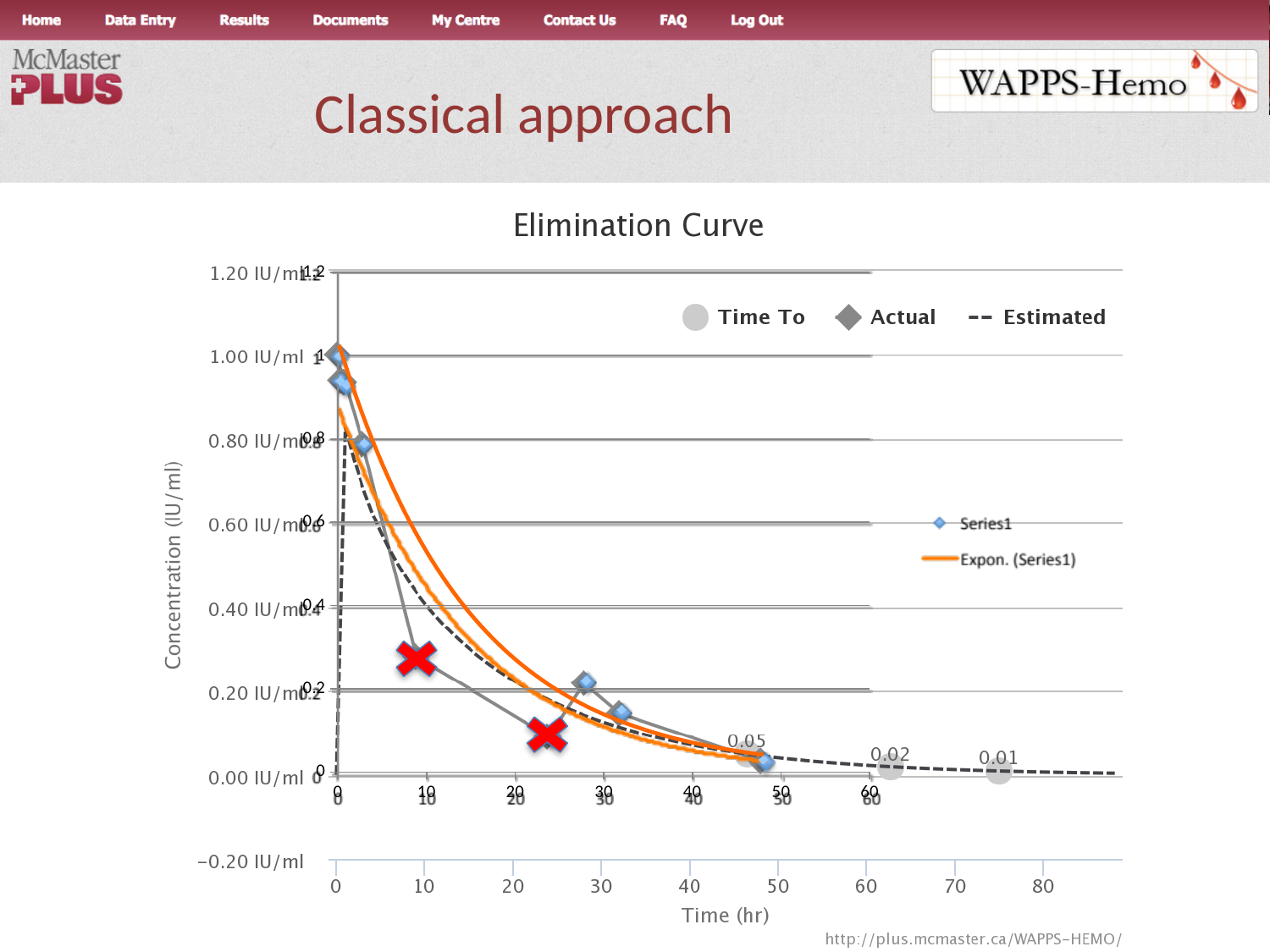
What is the largest value printed as a data label on the Time To series? 0.05 How many Time To points have printed data labels? 3 What is the difference between the labelled Time To values 0.05 and 0.02? 0.03 Is the Actual concentration at about 28 hours greater or less than 0.40? less What is the smallest value printed as a data label on the Time To series? 0.01 Do the Actual concentration values rise or fall as time increases along the x axis? fall How many series does the legend at the top of the chart list? 3 Is the Actual concentration at time 0 greater or less than 0.80? greater What is the label of the vertical axis? Concentration (IU/ml) Which labelled Time To value is larger, the one at about 47 hours or the one at about 75 hours? 0.05 (at about 47 hours) What kind of chart is the Elimination Curve? line chart What is the title of the chart? Elimination Curve